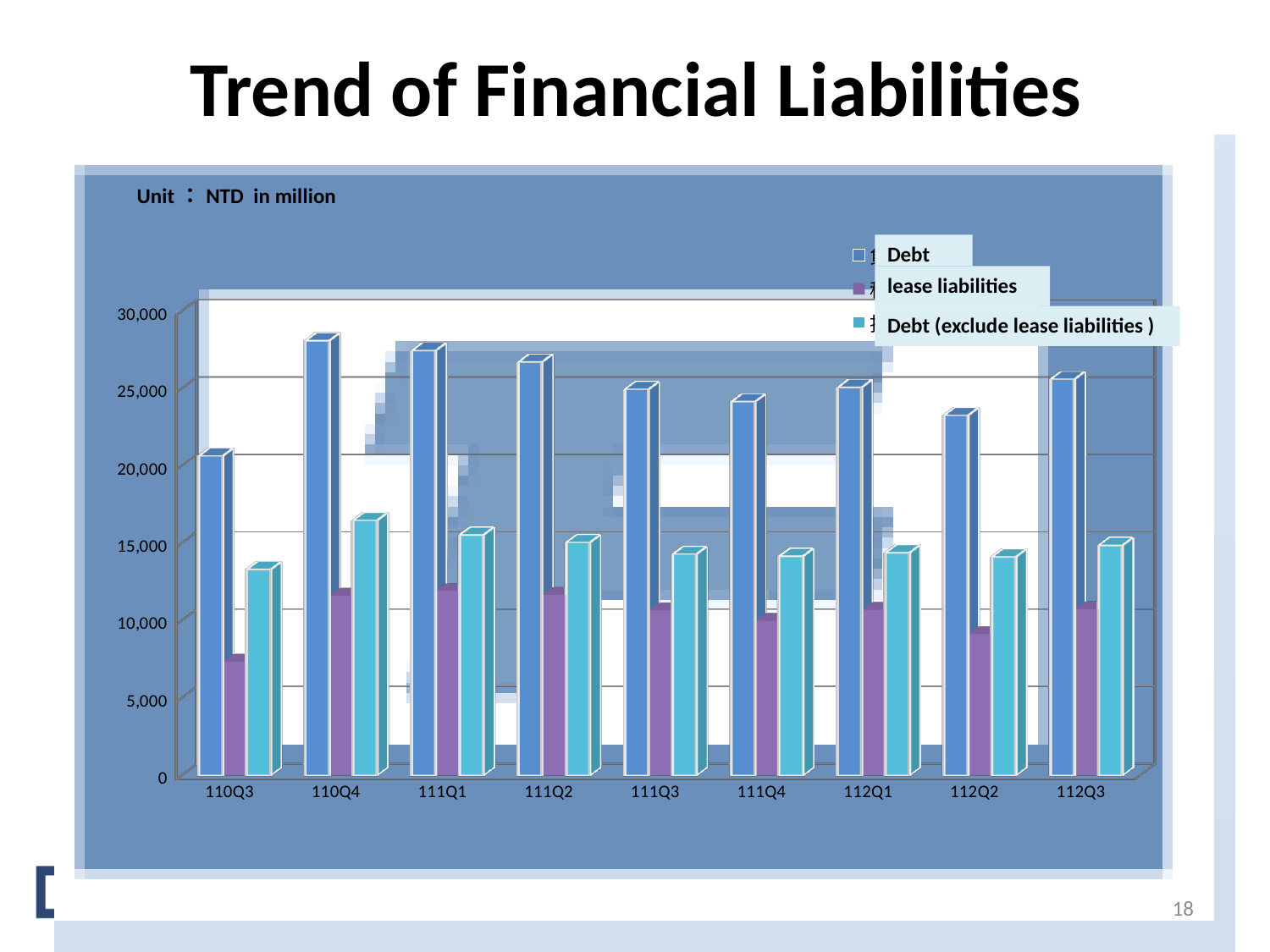
Which quarter has the lowest lease liabilities value? 110Q3 What unit is stated for the values in the chart? NTD in million How many quarters are shown on the x axis of the chart? 9 What type of chart is shown on the slide? Bar chart Which is larger, the Debt value for 110Q3 or for 110Q4? 110Q4 Is the Debt value for 110Q4 greater or less than 25,000? greater Is the Debt value for 110Q3 greater or less than 25,000? less Which quarter has the lowest Debt value? 110Q3 Is the lease liabilities value for 110Q3 greater or less than 10,000? less How many series does the chart's legend list? 3 What is the title of the chart on the slide? Trend of Financial Liabilities